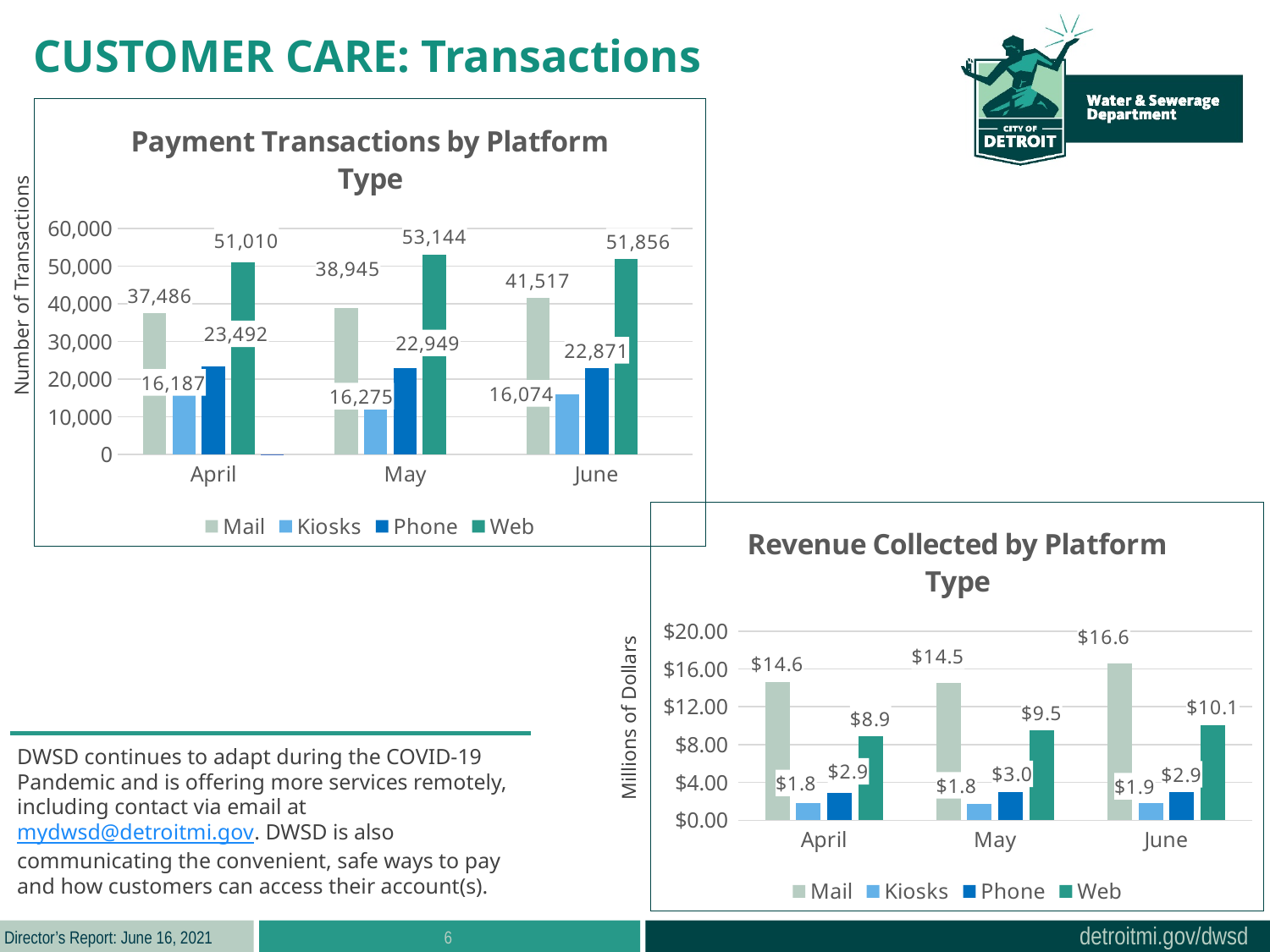
What kind of chart is the 'Payment Transactions by Platform Type' chart? Bar chart What is the y-axis label of the 'Revenue Collected by Platform Type' chart? Millions of Dollars In the 'Revenue Collected by Platform Type' chart, how much higher was Web revenue in June than in April? $1.2 How many series does the legend of the 'Revenue Collected by Platform Type' chart list? 4 In the 'Payment Transactions by Platform Type' chart, which month had the lowest number of Kiosks transactions? June In the 'Payment Transactions by Platform Type' chart, what is the difference between Web and Mail transactions in April? 13,524 In the 'Revenue Collected by Platform Type' chart, what was the revenue collected by Mail in June? $16.6 In the 'Payment Transactions by Platform Type' chart, which month had the highest number of Web transactions? May In the 'Payment Transactions by Platform Type' chart, do Mail transactions rise or fall from April to June? Rise How many months are shown on the x axis of the 'Revenue Collected by Platform Type' chart? 3 In the 'Payment Transactions by Platform Type' chart, which had more transactions in June, Phone or Kiosks? Phone In the 'Payment Transactions by Platform Type' chart, how many Web transactions were there in May? 53,144